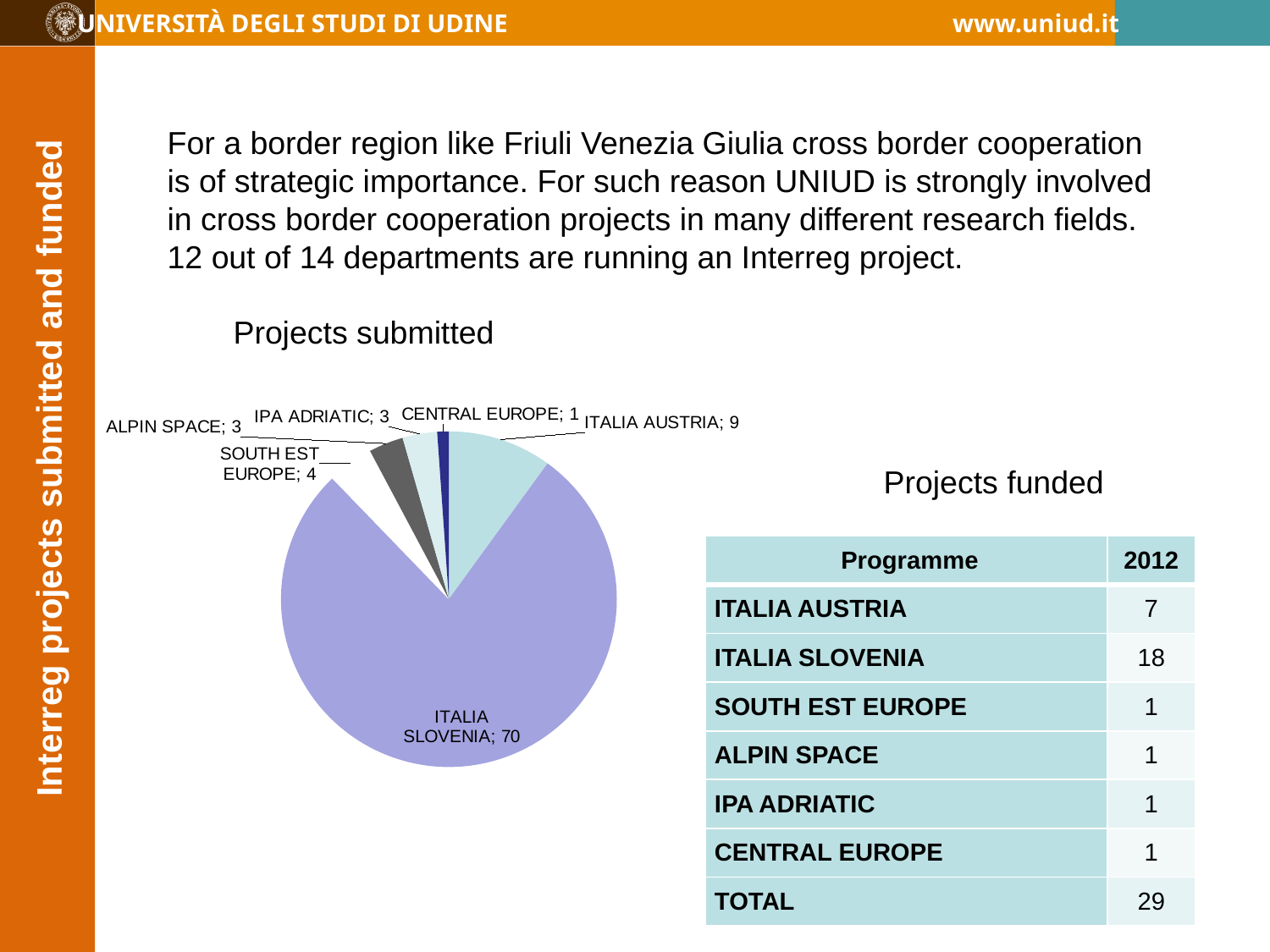
What is the total of all slices in the "Projects submitted" pie chart? 90 In the "Projects submitted" pie chart, what is the value for SOUTH EST EUROPE? 4 In the "Projects submitted" pie chart, how many projects were submitted under ITALIA SLOVENIA? 70 Which programme has the smallest slice in the "Projects submitted" pie chart? CENTRAL EUROPE In the "Projects submitted" pie chart, what is the value for CENTRAL EUROPE? 1 In the "Projects submitted" pie chart, what share of the total does ITALIA AUSTRIA represent? 10% What type of chart is shown under the heading "Projects submitted"? Pie chart How many slices does the "Projects submitted" pie chart have? 6 In the "Projects submitted" pie chart, how many projects were submitted under ITALIA AUSTRIA? 9 In the "Projects submitted" pie chart, what is the difference between the ITALIA SLOVENIA and ITALIA AUSTRIA values? 61 Which programme has the largest slice in the "Projects submitted" pie chart? ITALIA SLOVENIA In the "Projects submitted" pie chart, which is larger: SOUTH EST EUROPE or ALPIN SPACE? SOUTH EST EUROPE